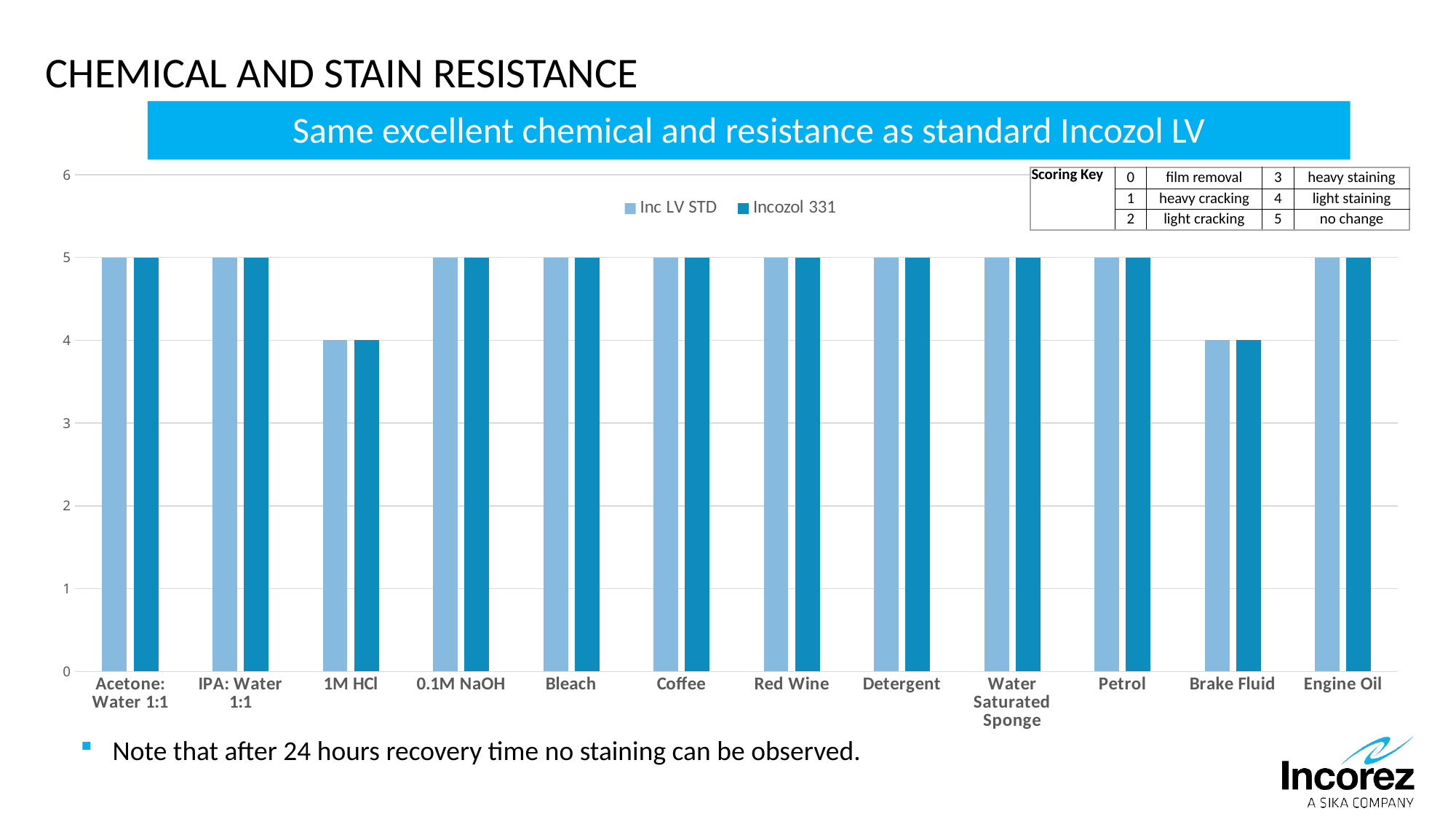
How many series does the chart legend list? 2 Which is larger: the Inc LV STD score for Petrol or the Inc LV STD score for Brake Fluid? Petrol What are the two series names listed in the chart legend? Inc LV STD and Incozol 331 What is the score for Inc LV STD for 1M HCl? 4 Is the Incozol 331 score for Red Wine greater or less than 3? greater What is the score for Incozol 331 for Coffee? 5 How many chemical categories are shown on the x axis of the chart? 12 What is the score for Incozol 331 for Brake Fluid? 4 What is the difference between the Incozol 331 score for Bleach and the Incozol 331 score for 1M HCl? 1 What is the score for Inc LV STD for Engine Oil? 5 What kind of chart is shown on the slide? bar chart Which categories have the lowest score for Incozol 331? 1M HCl and Brake Fluid